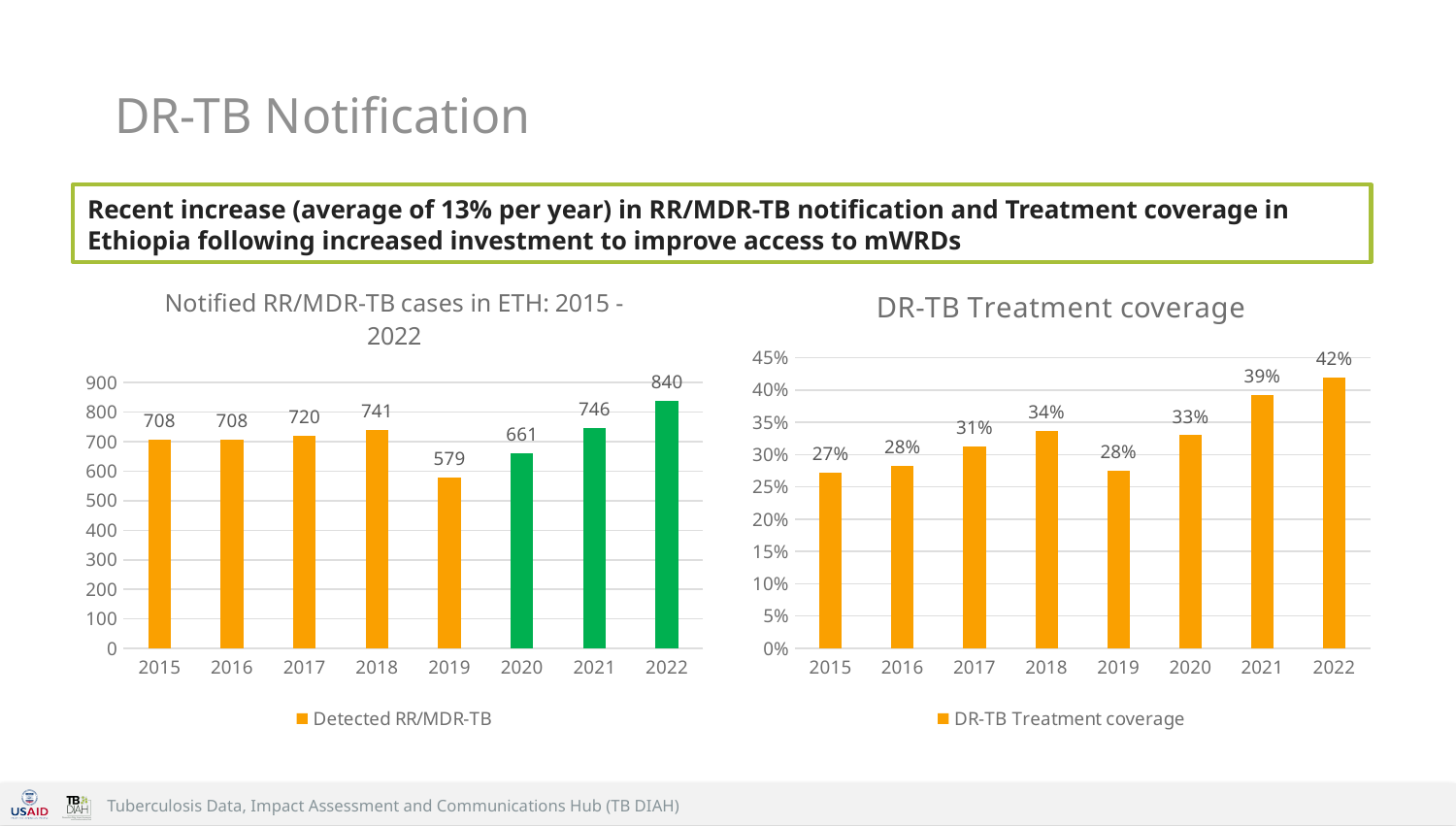
In the 'Notified RR/MDR-TB cases in ETH: 2015 - 2022' chart, how many years are shown on the x axis? 8 In the 'DR-TB Treatment coverage' chart, which year has the highest value? 2022 In the 'Notified RR/MDR-TB cases in ETH: 2015 - 2022' chart, which year has the highest value? 2022 In the 'Notified RR/MDR-TB cases in ETH: 2015 - 2022' chart, what is the value for 2019? 579 In the 'Notified RR/MDR-TB cases in ETH: 2015 - 2022' chart, what is the difference between the values for 2022 and 2021? 94 In the 'DR-TB Treatment coverage' chart, how many series does the legend list? 1 In the 'Notified RR/MDR-TB cases in ETH: 2015 - 2022' chart, what kind of chart is it? Bar chart In the 'DR-TB Treatment coverage' chart, what is the value for 2018? 34% In the 'DR-TB Treatment coverage' chart, which is larger, the value for 2017 or the value for 2019? 2017 In the 'Notified RR/MDR-TB cases in ETH: 2015 - 2022' chart, which year has the lowest value? 2019 In the 'Notified RR/MDR-TB cases in ETH: 2015 - 2022' chart, what is the legend entry? Detected RR/MDR-TB In the 'DR-TB Treatment coverage' chart, what is the difference between the values for 2022 and 2015? 15%